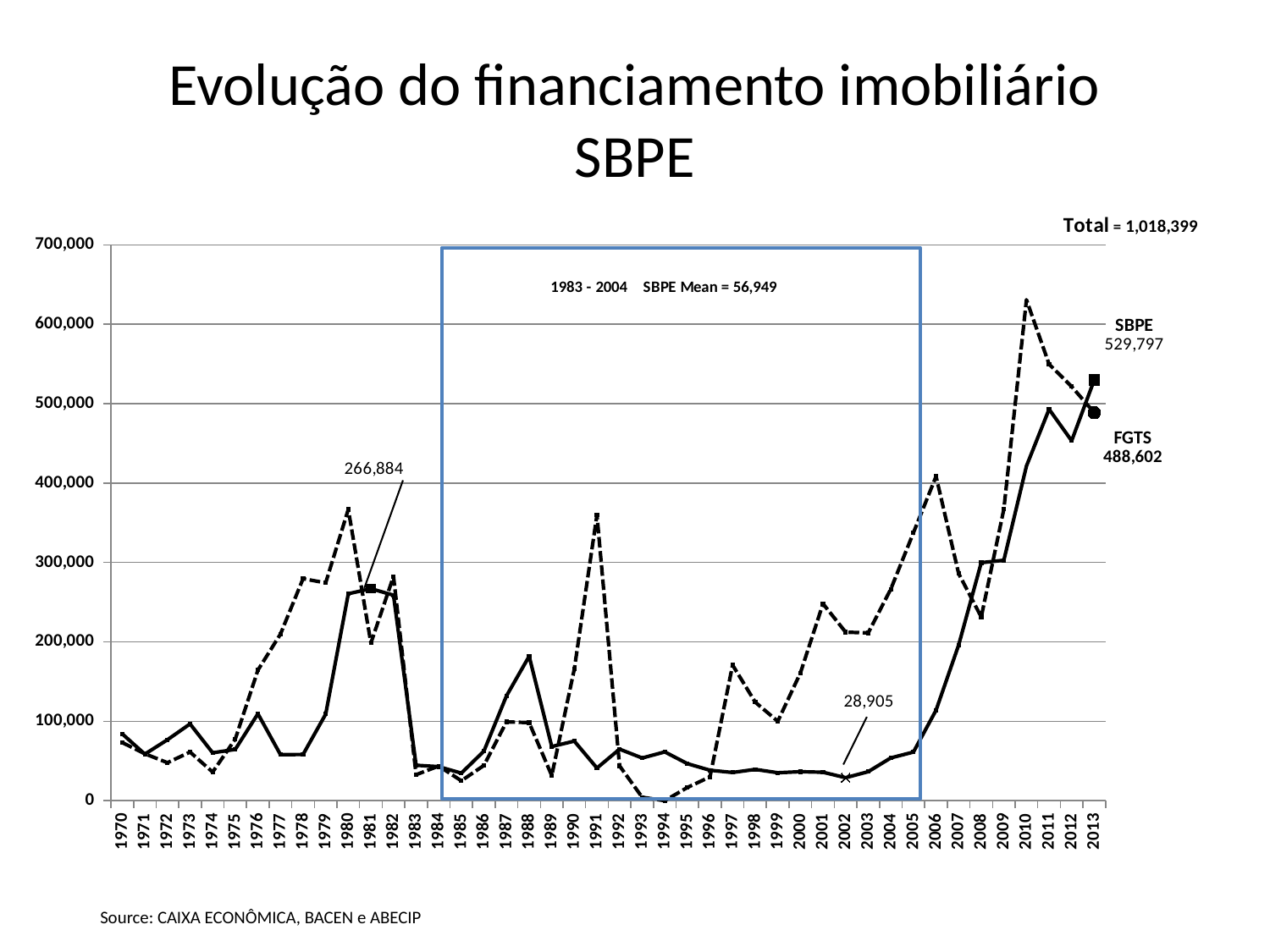
How many series are plotted on the chart? 2 Is the FGTS value for 2010 greater or less than 600,000? greater What value is annotated on the SBPE line at 1981? 266,884 What value is annotated on the SBPE line at 2002? 28,905 What is the SBPE mean for 1983 - 2004 stated inside the boxed region? 56,949 What is the FGTS value labelled for 2013? 488,602 Which series has the larger value in 2013, SBPE or FGTS? SBPE What is the SBPE value labelled for 2013? 529,797 What is the difference between the SBPE and FGTS values labelled for 2013? 41,195 What kind of chart is shown on the slide? Line chart What source is cited below the chart? CAIXA ECONÔMICA, BACEN e ABECIP What total is shown at the top right of the chart? 1,018,399